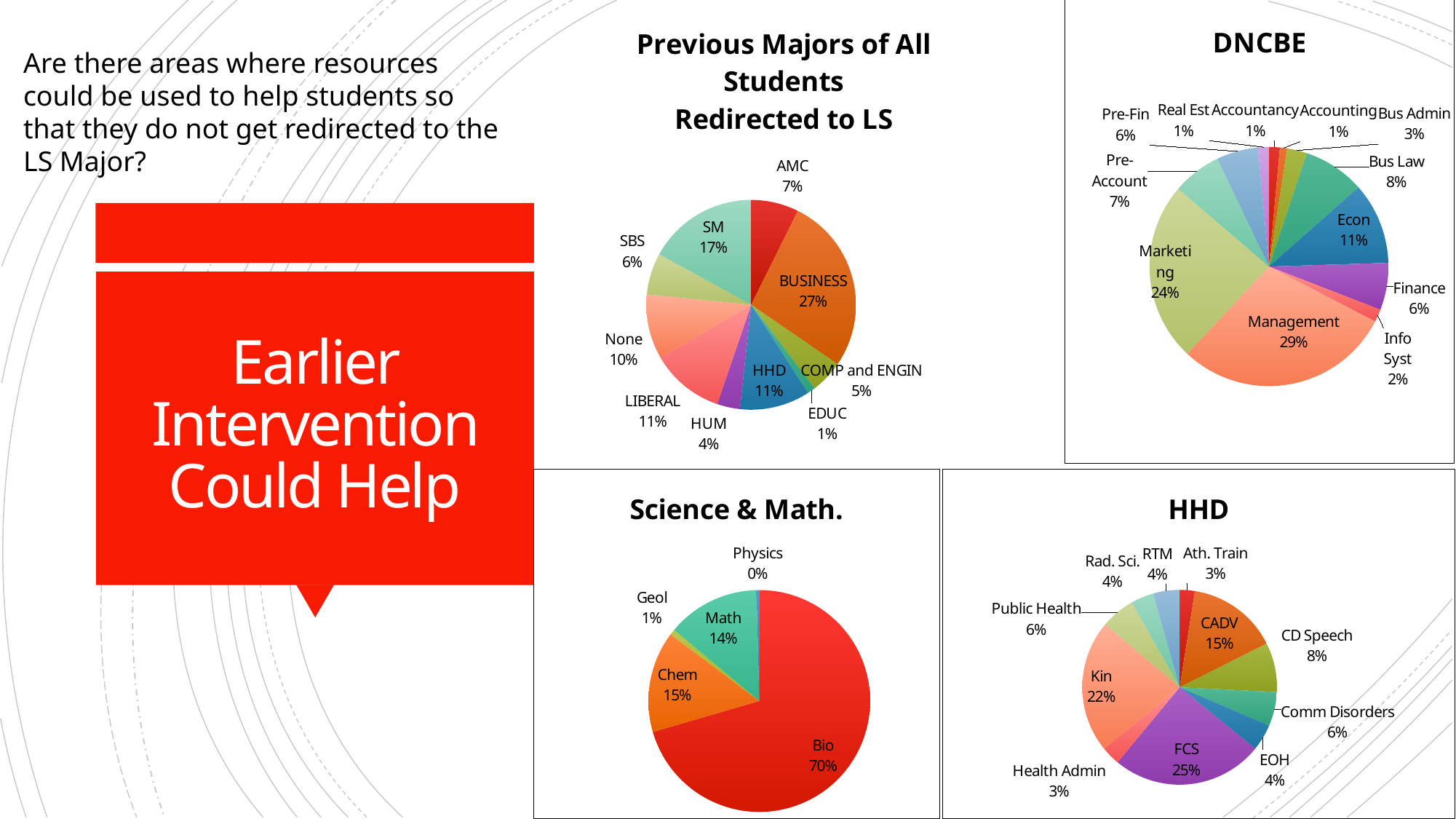
In the DNCBE chart, what is the difference between the Management and Marketing shares? 5% In the HHD chart, what share does Kin have? 22% In the 'Previous Majors of All Students Redirected to LS' pie chart, which category has the largest share? BUSINESS In the 'Previous Majors of All Students Redirected to LS' pie chart, what share does BUSINESS have? 27% In the Science & Math. chart, how many categories are shown? 5 In the 'Previous Majors of All Students Redirected to LS' pie chart, how many categories are shown? 10 What type of chart is the Science & Math. chart? Pie chart In the HHD chart, which category has the largest share? FCS In the DNCBE chart, which is larger, Econ or Bus Law? Econ In the 'Previous Majors of All Students Redirected to LS' pie chart, which category has the smallest share? EDUC In the DNCBE chart, what share does Management have? 29% In the Science & Math. chart, what share does Bio have? 70%